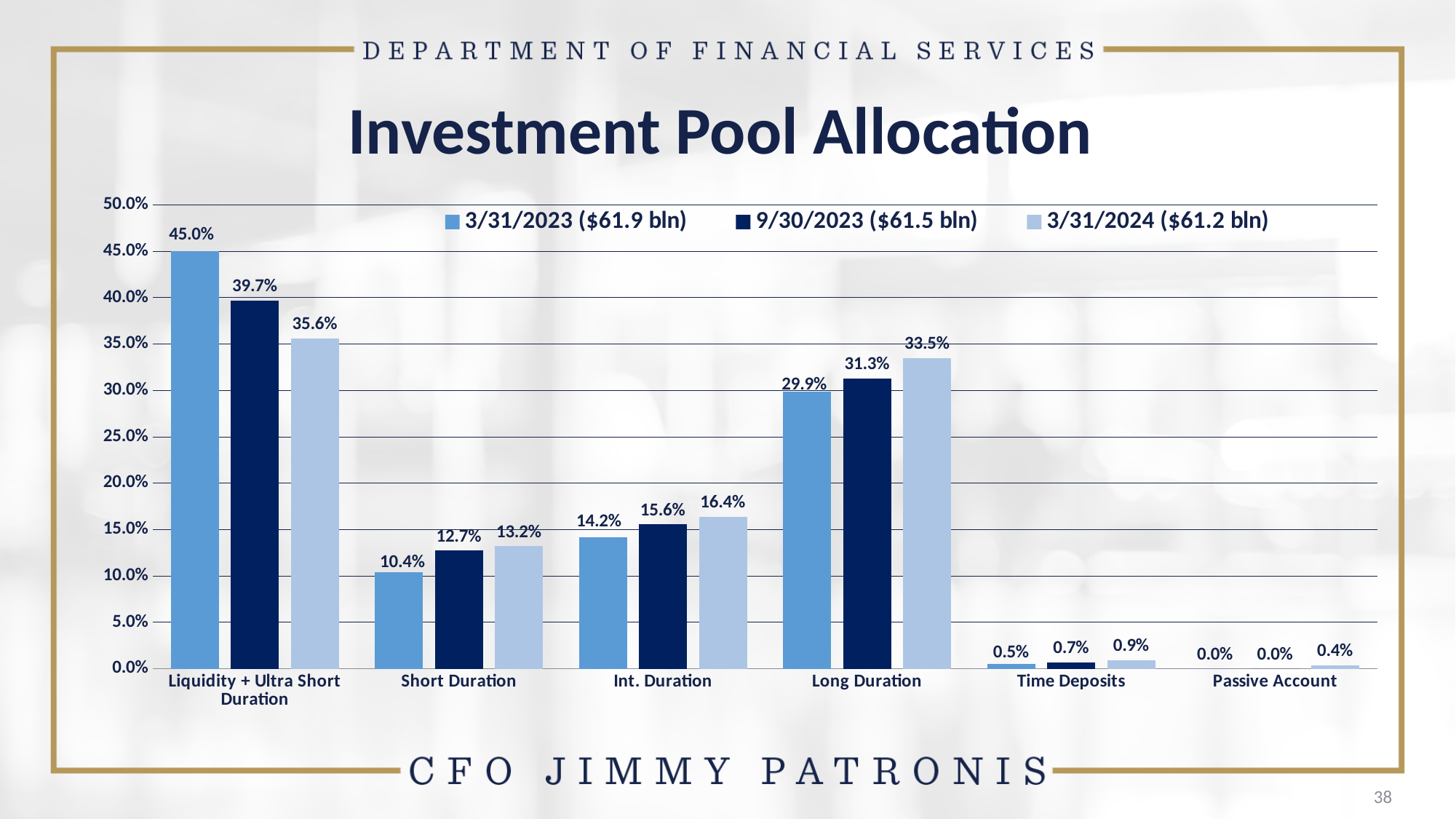
What is the value for Long Duration in the 3/31/2024 ($61.2 bln) series? 33.5% Which is larger for Int. Duration: the 3/31/2023 ($61.9 bln) value or the 3/31/2024 ($61.2 bln) value? 3/31/2024 ($61.2 bln) What kind of chart is shown on the slide? Bar chart What is the value for Liquidity + Ultra Short Duration in the 3/31/2023 ($61.9 bln) series? 45.0% Which category has the highest value in the 3/31/2024 ($61.2 bln) series? Liquidity + Ultra Short Duration How many categories are shown on the x axis? 6 How many series does the legend list? 3 What is the difference between the 3/31/2023 and 3/31/2024 values for Liquidity + Ultra Short Duration? 9.4% What is the title of the chart? Investment Pool Allocation Which category has the lowest value in the 3/31/2023 ($61.9 bln) series? Passive Account What is the value for Short Duration in the 9/30/2023 ($61.5 bln) series? 12.7% Is the value for Long Duration in the 9/30/2023 ($61.5 bln) series greater or less than 30.0%? greater